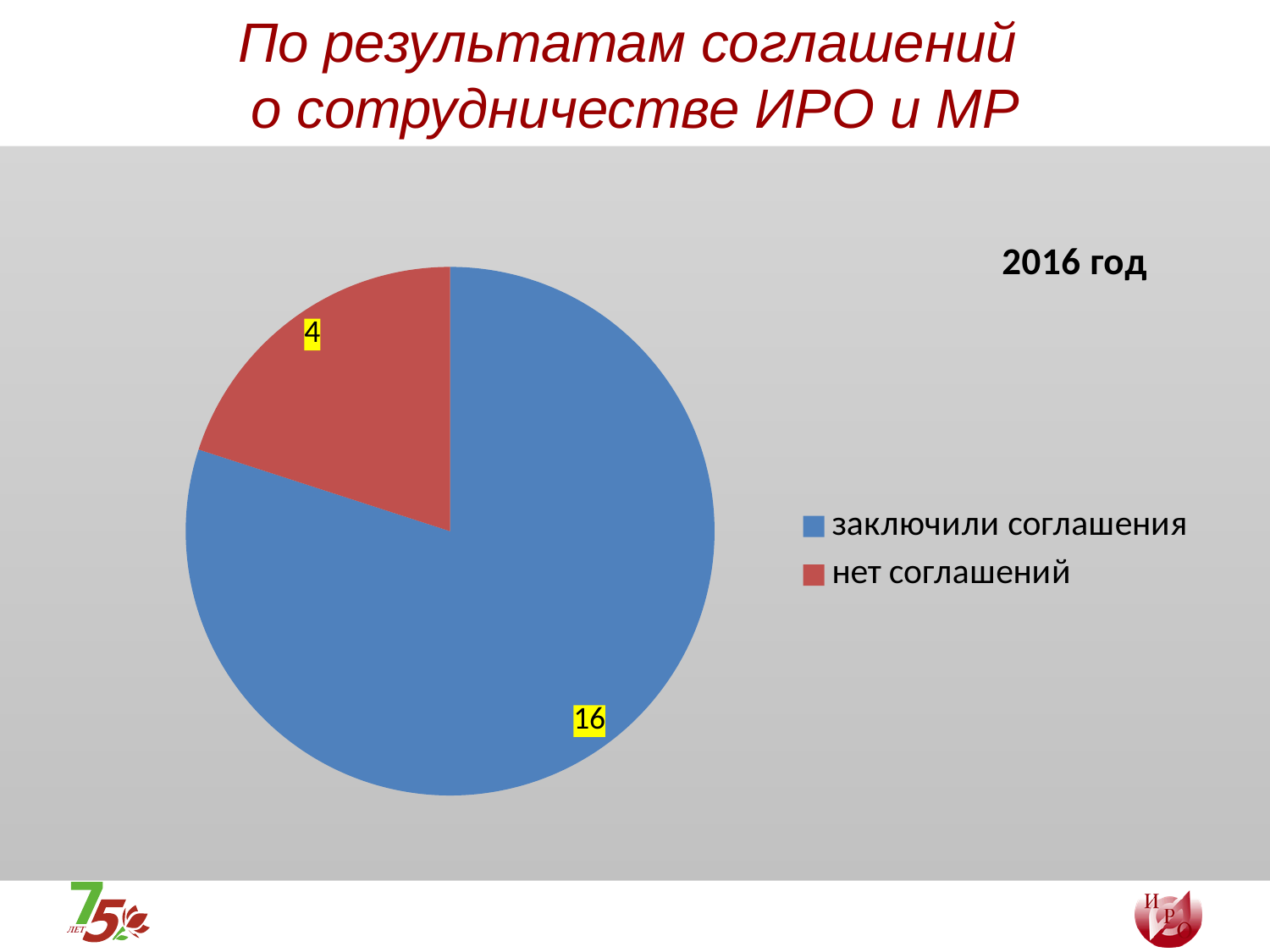
What share of the pie does "заключили соглашения" represent? 80% Which is larger: "заключили соглашения" or "нет соглашений"? заключили соглашения What is the total of all slices in the pie chart? 20 What is the value for "нет соглашений"? 4 What kind of chart is shown on the slide? pie chart Which year is labelled on the chart? 2016 год Which category has the smallest slice? нет соглашений What is the difference between the values for "заключили соглашения" and "нет соглашений"? 12 What is the value for "заключили соглашения"? 16 What share of the pie does "нет соглашений" represent? 20% How many slices does the pie chart have? 2 Which category has the largest slice? заключили соглашения